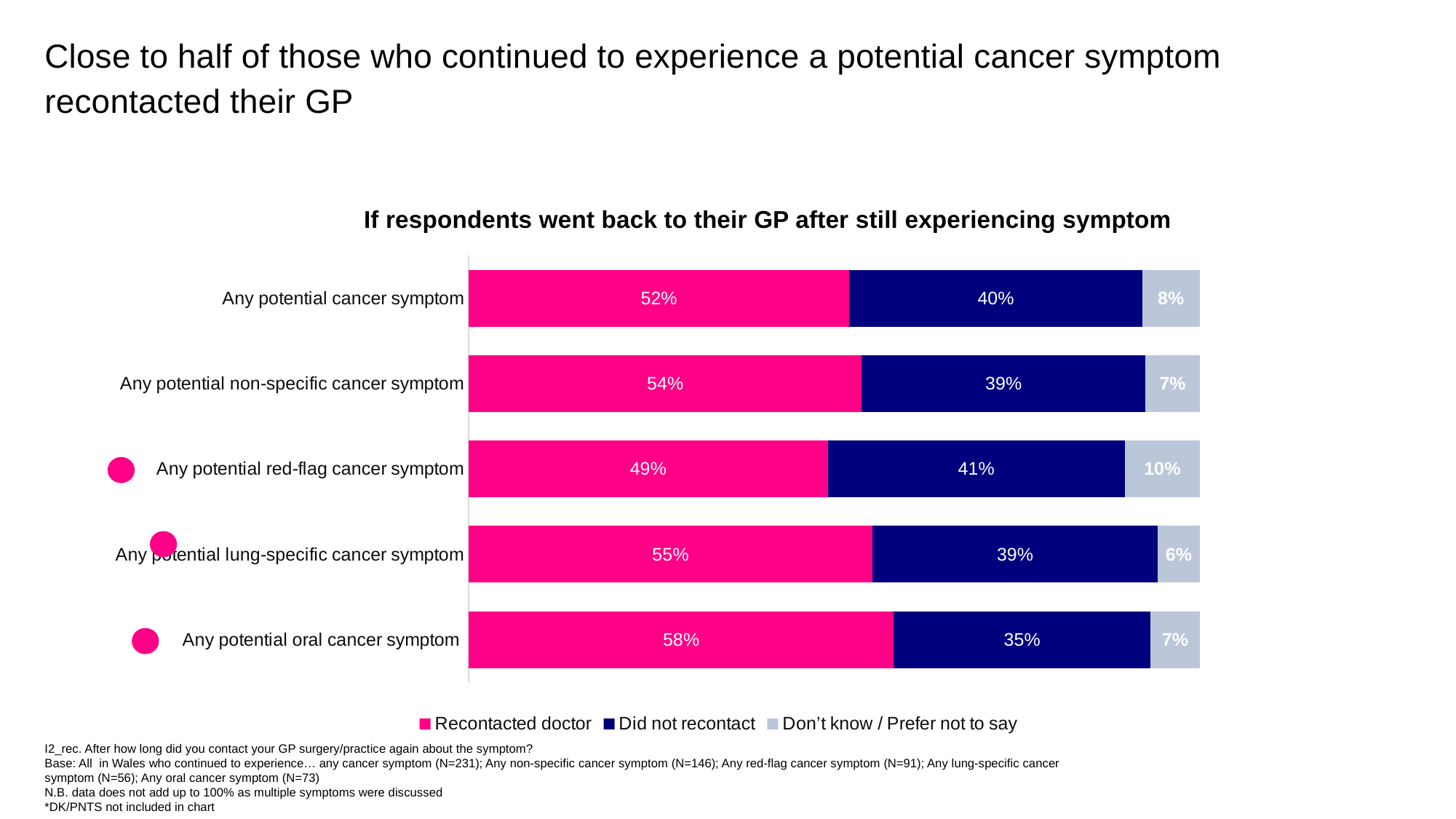
What percentage of respondents with any potential oral cancer symptom did not recontact their GP? 35% What is the 'Don't know / Prefer not to say' value for any potential red-flag cancer symptom? 10% What is the difference between the 'Recontacted doctor' percentages for any potential oral cancer symptom and any potential red-flag cancer symptom? 9% Which category has the highest percentage of respondents who recontacted their doctor? Any potential oral cancer symptom What is the total of the stacked bar for any potential lung-specific cancer symptom? 100% How many series does the legend list? 3 What is the title of the chart? If respondents went back to their GP after still experiencing symptom Which is larger: the 'Did not recontact' value for any potential red-flag cancer symptom or for any potential oral cancer symptom? Any potential red-flag cancer symptom How many categories are shown on the chart? 5 What kind of chart is shown on the slide? Stacked bar chart Which category has the lowest percentage of respondents who recontacted their doctor? Any potential red-flag cancer symptom What percentage of respondents with any potential cancer symptom recontacted their doctor? 52%